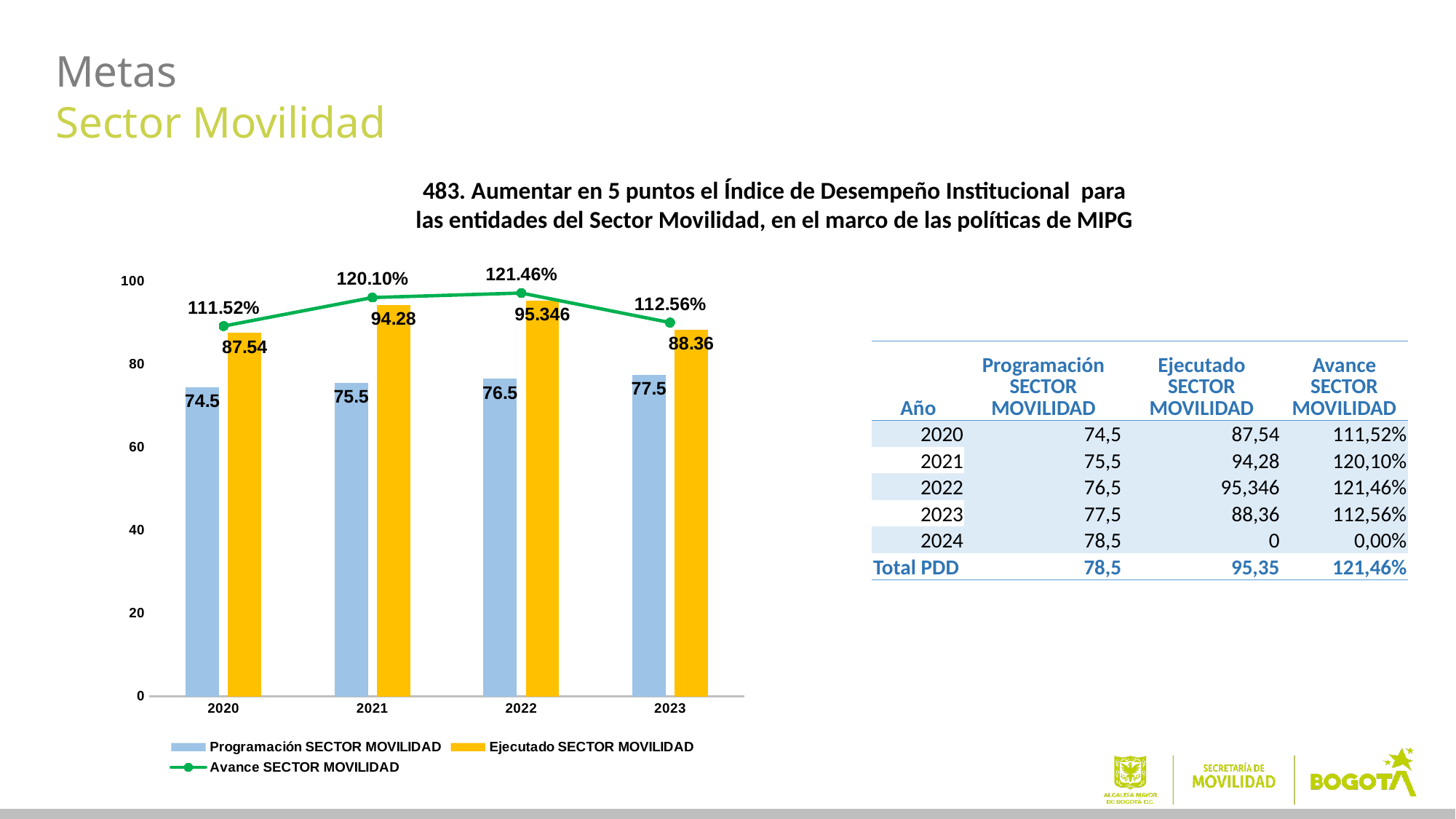
How many series does the chart legend list? 3 Which year has the lowest Avance SECTOR MOVILIDAD value? 2020 What is the value of Ejecutado SECTOR MOVILIDAD for 2021? 94.28 What is the Avance SECTOR MOVILIDAD value shown for 2022? 121.46% What is the value of Programación SECTOR MOVILIDAD for 2023? 77.5 How many years are shown on the x axis of the chart? 4 What is the difference between the Ejecutado and Programación values for 2020? 13.04 Is the Ejecutado SECTOR MOVILIDAD value for 2020 greater or less than 80? greater Which year has the highest Ejecutado SECTOR MOVILIDAD value? 2022 Which series in the chart is drawn as a green line? Avance SECTOR MOVILIDAD Does the Programación SECTOR MOVILIDAD series rise or fall from 2020 to 2023? rise Which is larger in 2023, the Programación SECTOR MOVILIDAD bar or the Ejecutado SECTOR MOVILIDAD bar? Ejecutado SECTOR MOVILIDAD